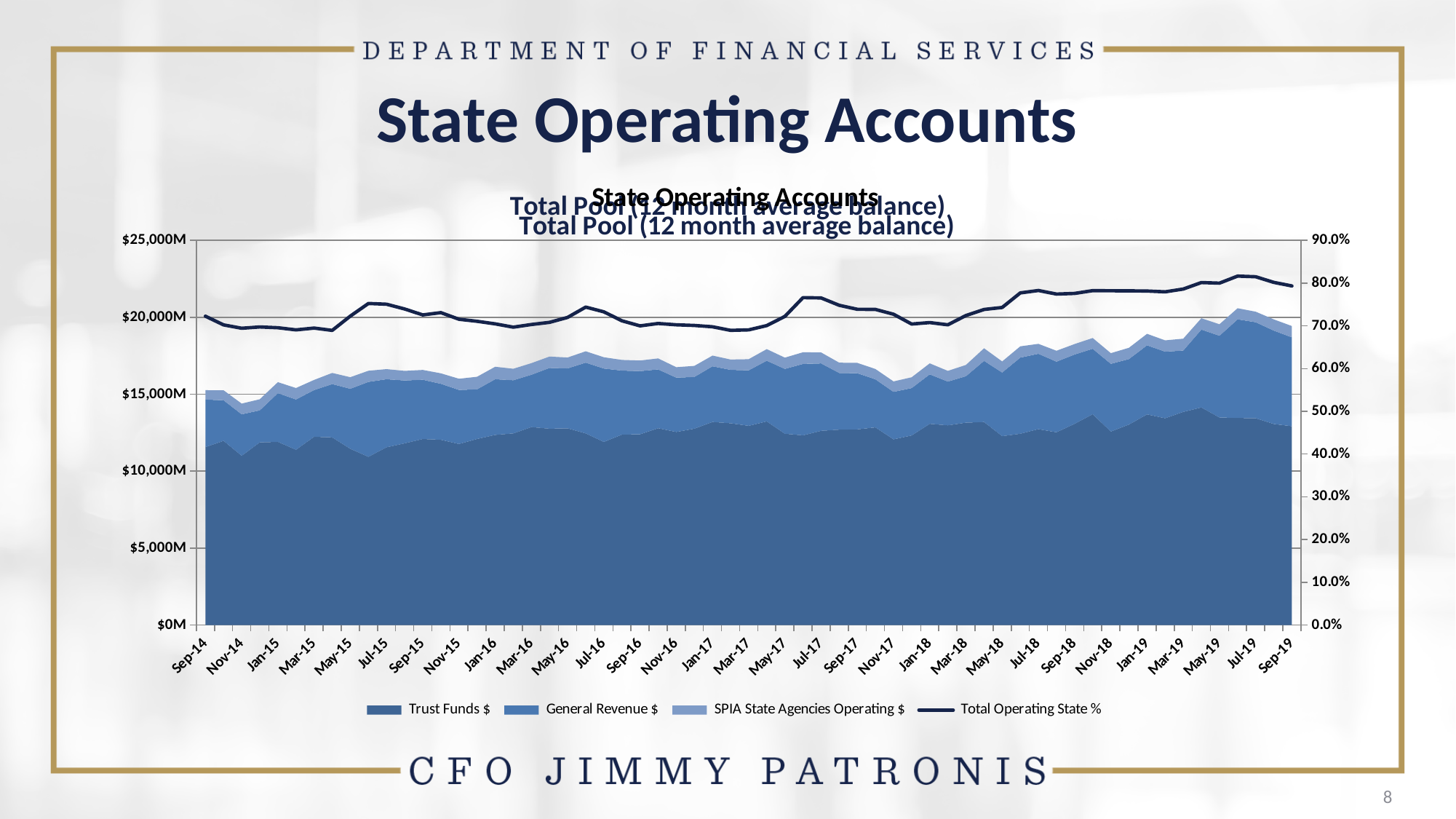
How many date labels are shown along the x axis? 31 At Sep-19, which is larger: the Trust Funds $ area or the General Revenue $ area? Trust Funds $ Which series is plotted as a line rather than a shaded area? Total Operating State % Is the total stacked balance at Jan-18 greater or less than $15,000M? greater Is the Trust Funds $ value at Sep-19 greater or less than $10,000M? greater Is the Total Operating State % value at Sep-19 greater or less than 70.0%? greater What kind of chart is shown on the slide? Stacked area chart with a line overlay Does the Total Operating State % line generally rise or fall from Sep-14 to Sep-19? rise What is the highest value shown on the right-hand percentage axis? 90.0% How many series does the legend list? 4